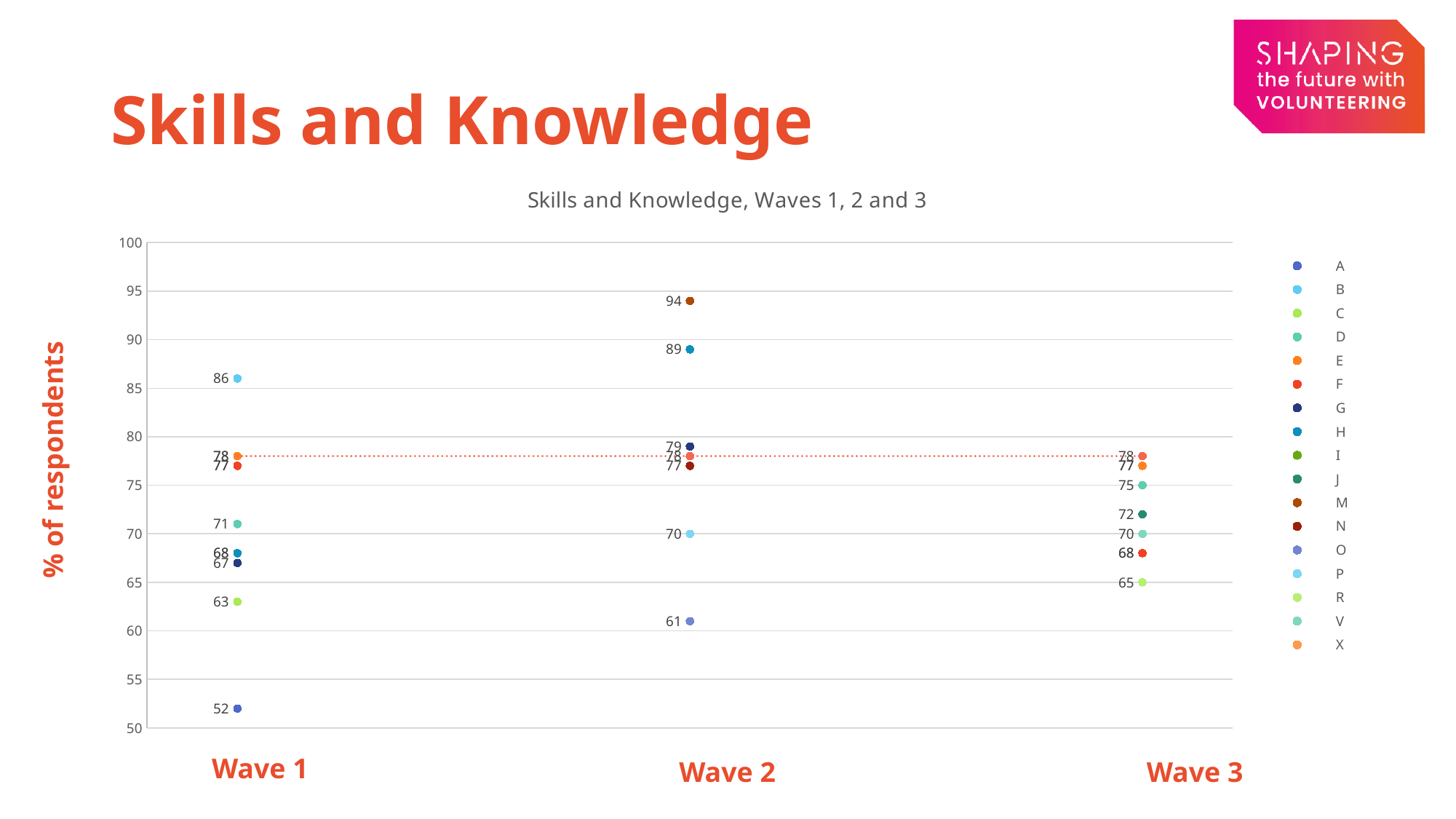
What is the lowest value plotted for Wave 2? 61 What is the label on the vertical axis of the chart? % of respondents What is the lowest value plotted for Wave 3? 65 What is the lowest value plotted for Wave 1? 52 What is the highest value plotted for Wave 3? 78 How many series does the legend list? 17 Which is larger: the highest value in Wave 2 or the highest value in Wave 1? Wave 2 What is the highest value plotted for Wave 2? 94 What is the difference between the highest and lowest values plotted for Wave 1? 34 What is the highest value plotted for Wave 1? 86 How many wave categories are shown on the x axis? 3 What is the title of the chart? Skills and Knowledge, Waves 1, 2 and 3